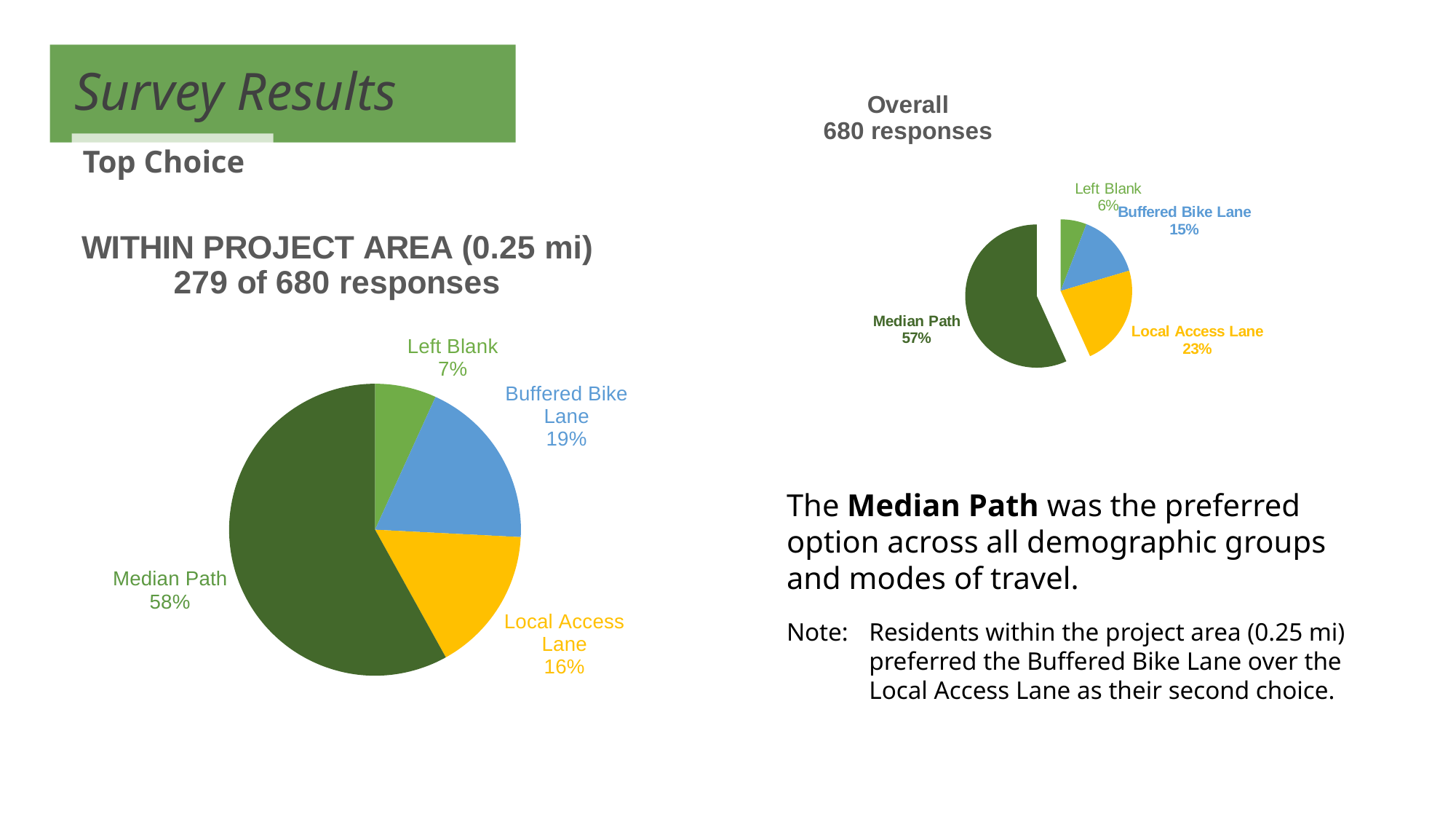
In the 'Within Project Area (0.25 mi)' pie chart, what share does Median Path have? 58% In the 'Overall' pie chart, which is larger: Buffered Bike Lane or Local Access Lane? Local Access Lane In the 'Within Project Area (0.25 mi)' pie chart, what share does Buffered Bike Lane have? 19% In the 'Overall' pie chart, what share does Local Access Lane have? 23% In the 'Overall' pie chart, what is the difference between the Median Path share and the Local Access Lane share? 34% In the 'Within Project Area (0.25 mi)' pie chart, what is the difference between the Buffered Bike Lane share and the Left Blank share? 12% How many slices does the 'Overall' pie chart have? 4 In the 'Within Project Area (0.25 mi)' pie chart, which category has the largest slice? Median Path What type of chart is used for the 'Within Project Area (0.25 mi)' data? Pie chart In the 'Overall' pie chart, which category has the smallest slice? Left Blank In the 'Within Project Area (0.25 mi)' pie chart, which is larger: Buffered Bike Lane or Local Access Lane? Buffered Bike Lane